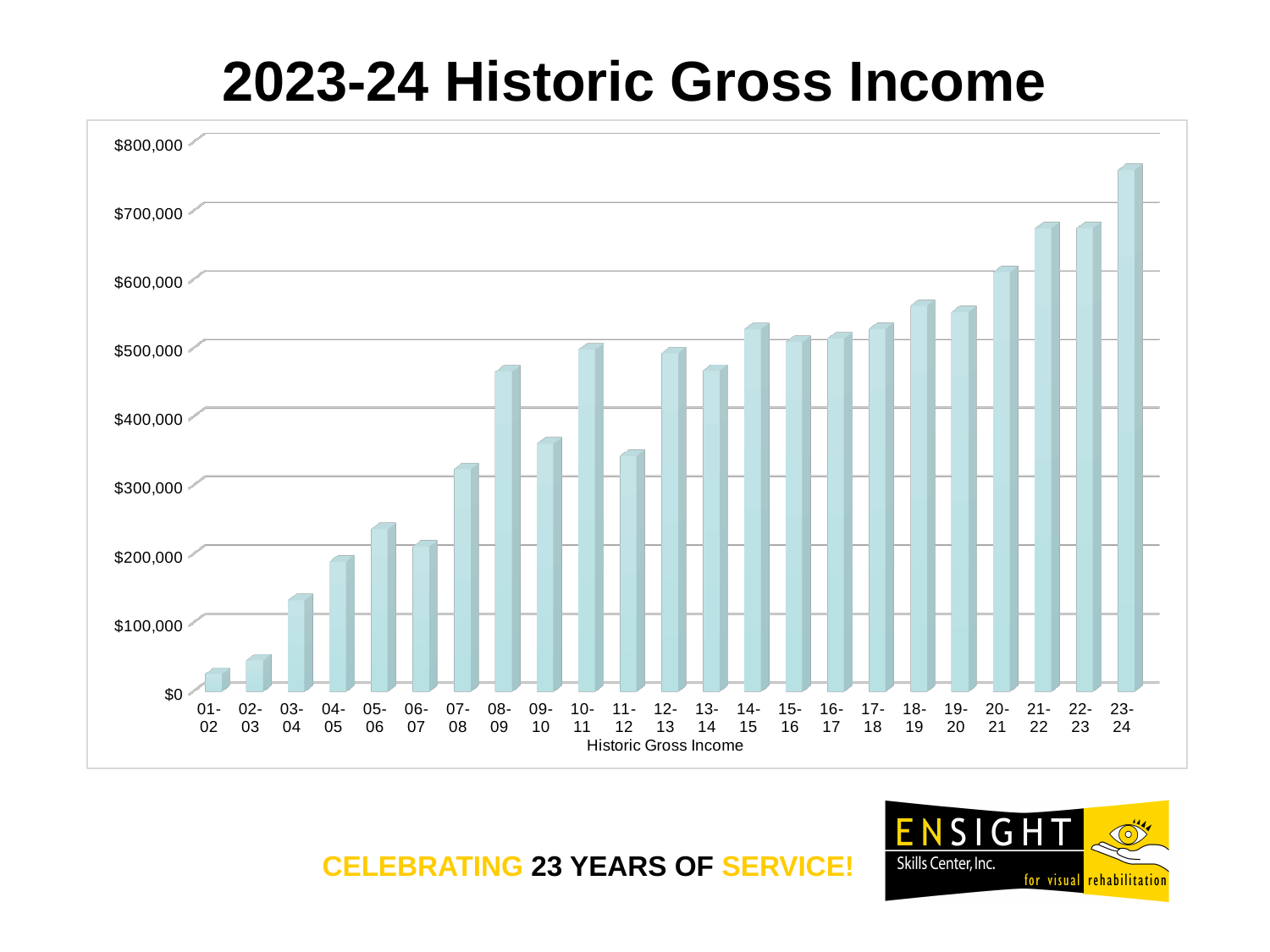
Which is larger, the value for 05-06 or the value for 06-07? 05-06 What kind of chart is shown on the slide? bar chart Which year has the lowest gross income? 01-02 Which year has the highest gross income? 23-24 Overall, do the values rise or fall from 01-02 to 23-24? rise Which is larger, the value for 08-09 or the value for 09-10? 08-09 Is the value for 11-12 greater or less than $400,000? less Is the value for 03-04 greater or less than $100,000? greater Is the value for 23-24 greater or less than $700,000? greater What is the label shown beneath the x axis of the chart? Historic Gross Income How many fiscal years are plotted on the chart? 23